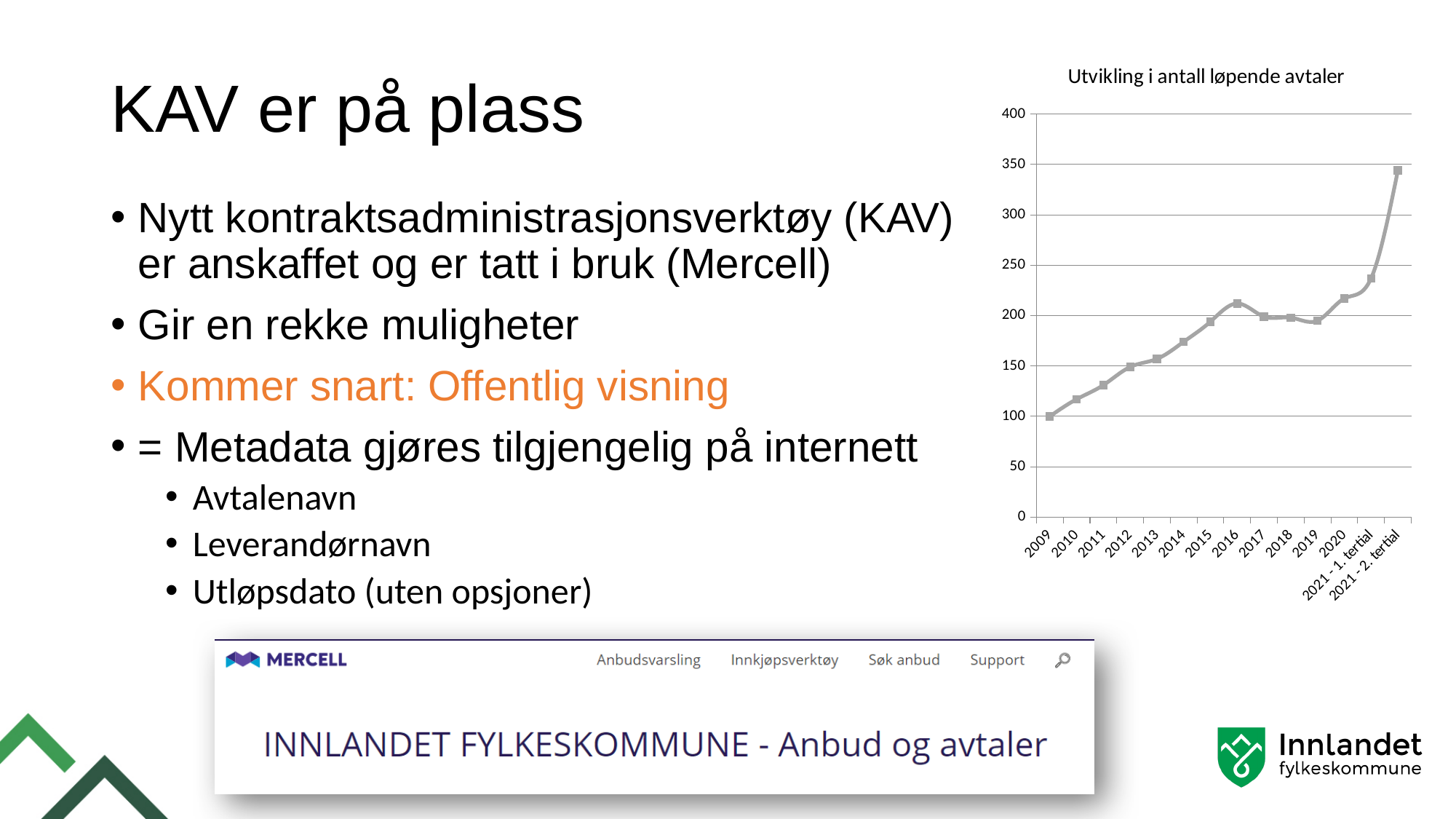
What is the title of the chart? Utvikling i antall løpende avtaler How many data points are plotted on the chart? 14 Is the value for 2009 greater or less than 150? less Is the value for 2021 - 2. tertial greater or less than 300? greater Do the values generally rise or fall from 2009 to 2021 - 2. tertial? rise Is the value for 2016 greater or less than 200? greater What kind of chart is shown on the slide? line chart Which category has the lowest value on the chart? 2009 Which is larger, the value for 2016 or the value for 2019? 2016 Which category has the highest value on the chart? 2021 - 2. tertial What is the highest value shown on the vertical axis? 400